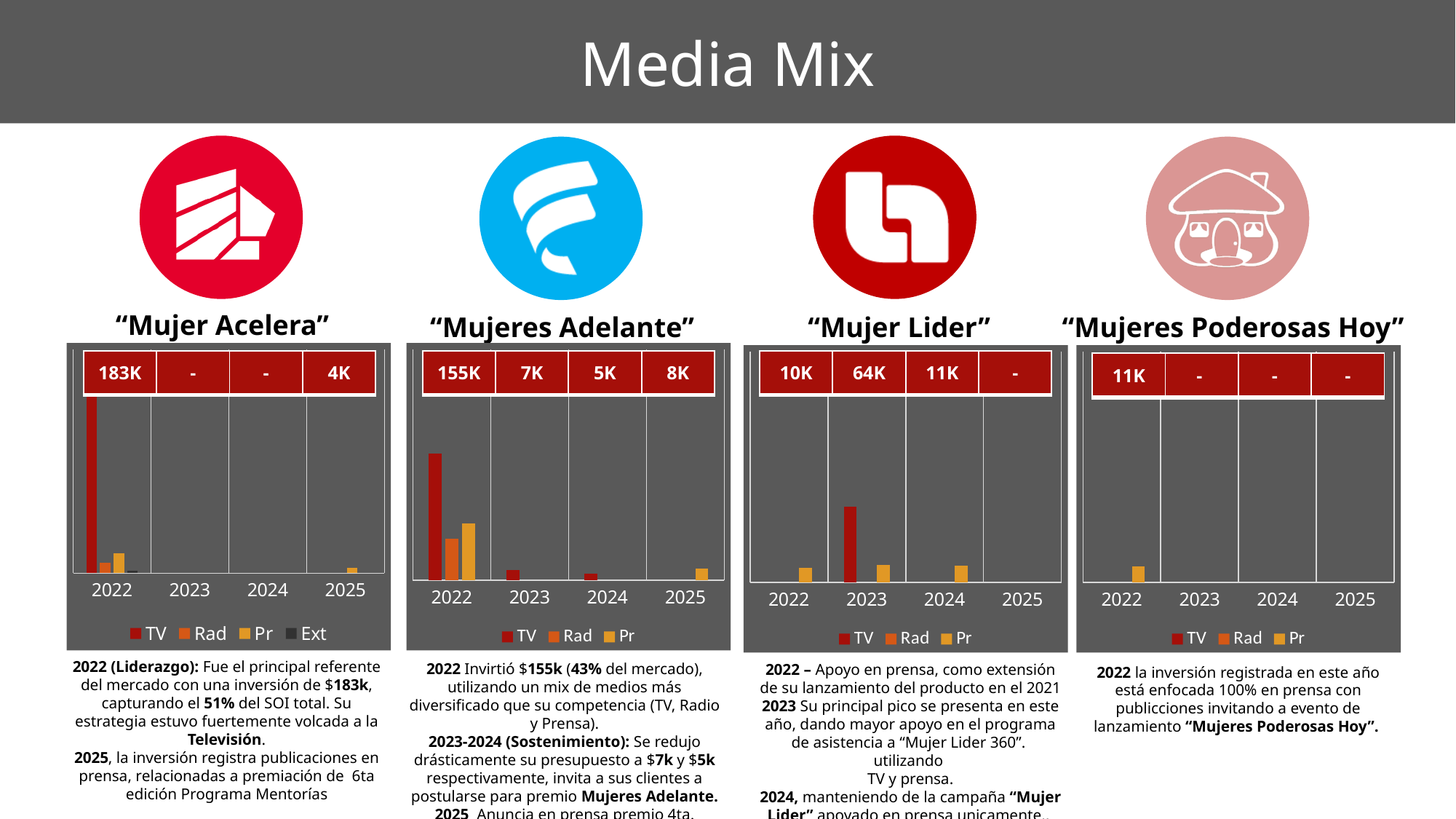
In the "Mujer Acelera" chart, what total value is shown for 2022? 183K In the "Mujeres Adelante" chart, what total value is shown for 2025? 8K How many series does the legend of the "Mujer Acelera" chart list? 4 In the "Mujeres Adelante" chart, what is the difference between the 2022 total and the 2023 total? 148K In the "Mujer Lider" chart, which year has the highest total value? 2023 How many series does the legend of the "Mujeres Adelante" chart list? 3 In the "Mujer Lider" chart, what total value is shown for 2024? 11K How many years are shown on the x axis of the "Mujeres Poderosas Hoy" chart? 4 In the "Mujer Lider" chart, which total is larger, 2022 or 2024? 2024 What kind of chart is the "Mujer Lider" chart? Bar chart In the "Mujeres Poderosas Hoy" chart, what total value is shown for 2022? 11K In the "Mujer Acelera" chart, which series has the tallest bar in 2022? TV